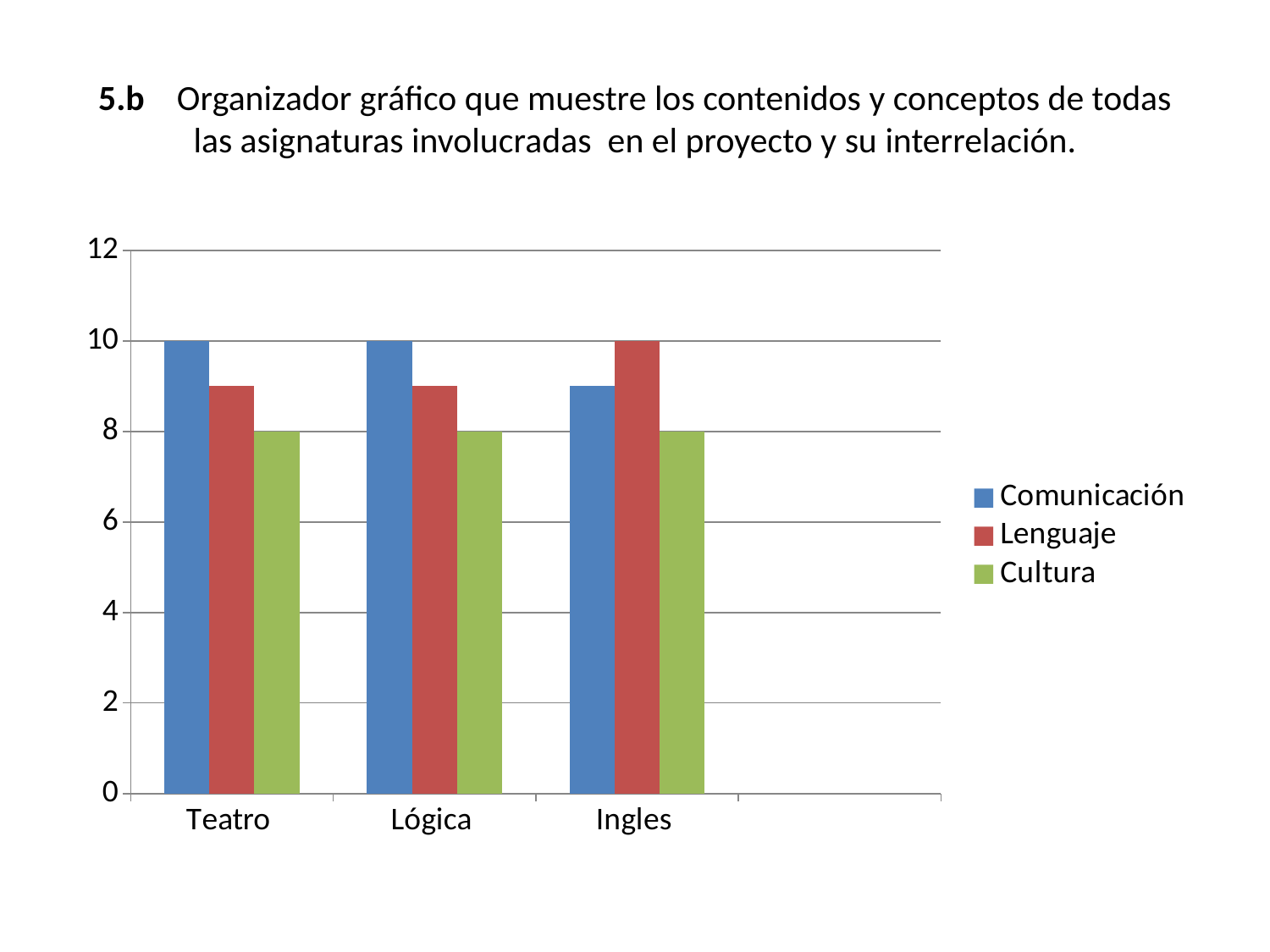
What is the difference between Comunicación and Cultura for Teatro? 2 Is the value of Comunicación for Ingles greater or less than 10? less What kind of chart is shown on the slide? bar chart What is the value of Cultura for Lógica? 8 Is the value of Lenguaje for Teatro greater or less than 8? greater What is the value of Lenguaje for Ingles? 10 How many categories are shown on the x axis of the chart? 3 How many series does the chart's legend list? 3 What is the value of Comunicación for Teatro? 10 For Teatro, which is larger: Comunicación or Cultura? Comunicación Which series has the highest value for Ingles? Lenguaje Which series has the lowest value for Teatro? Cultura